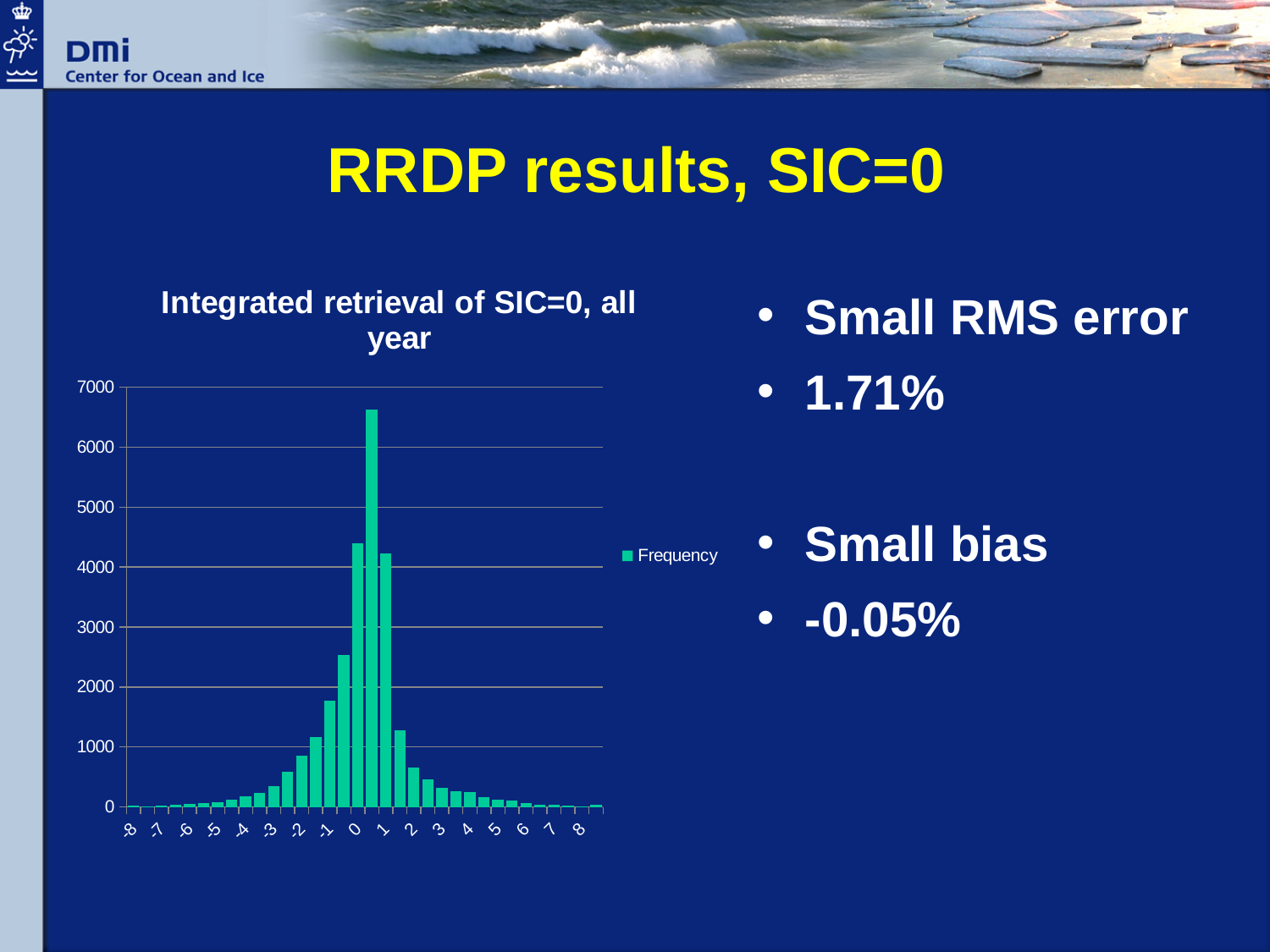
Do the bar values rise or fall along the x axis from -8 to 0? rise Is the value of the tallest bar greater or less than 6000? greater Do the bar values rise or fall along the x axis from 0 to 8? fall Which is larger, the bar at x = 0 or the bar at x = 8? 0 How many labelled tick values are shown on the x axis? 17 What series name is shown in the chart legend? Frequency Is the value of the bar at x = 8 greater or less than 1000? less How many series does the chart legend list? 1 Is the value of the bar at x = -8 greater or less than 1000? less What kind of chart is shown on the slide? bar chart What is the title of the chart? Integrated retrieval of SIC=0, all year